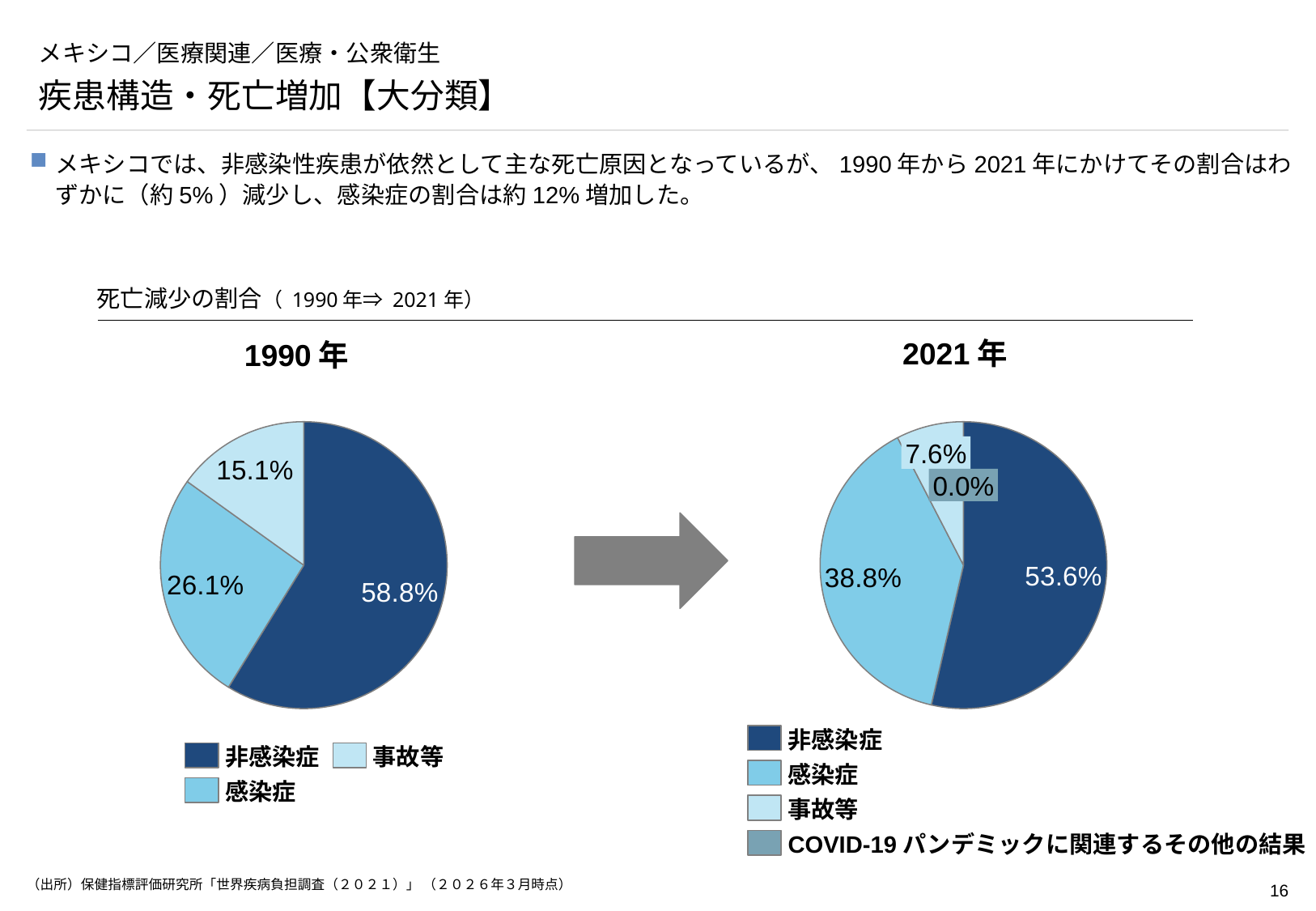
このスライドのグラフはどの種類のグラフですか？ 円グラフ 2021年の円グラフで、事故等の割合はいくらですか？ 7.6% 2021年の円グラフで、非感染症と感染症ではどちらの割合が大きいですか？ 非感染症 1990年の円グラフで、最も割合が小さい項目はどれですか？ 事故等 2021年の円グラフで、感染症の割合はいくらですか？ 38.8% 1990年の円グラフには、いくつの項目がありますか？ 3 2021年の円グラフの凡例には、いくつの項目が示されていますか？ 4 2021年の円グラフで、COVID-19パンデミックに関連するその他の結果の割合はいくらですか？ 0.0% 2021年の円グラフで、最も割合が小さい項目はどれですか？ COVID-19パンデミックに関連するその他の結果 1990年の円グラフで、非感染症の割合はいくらですか？ 58.8% 1990年の円グラフで、感染症と事故等の割合の差はいくらですか？ 11.0% 1990年の円グラフで、最も割合が大きい項目はどれですか？ 非感染症